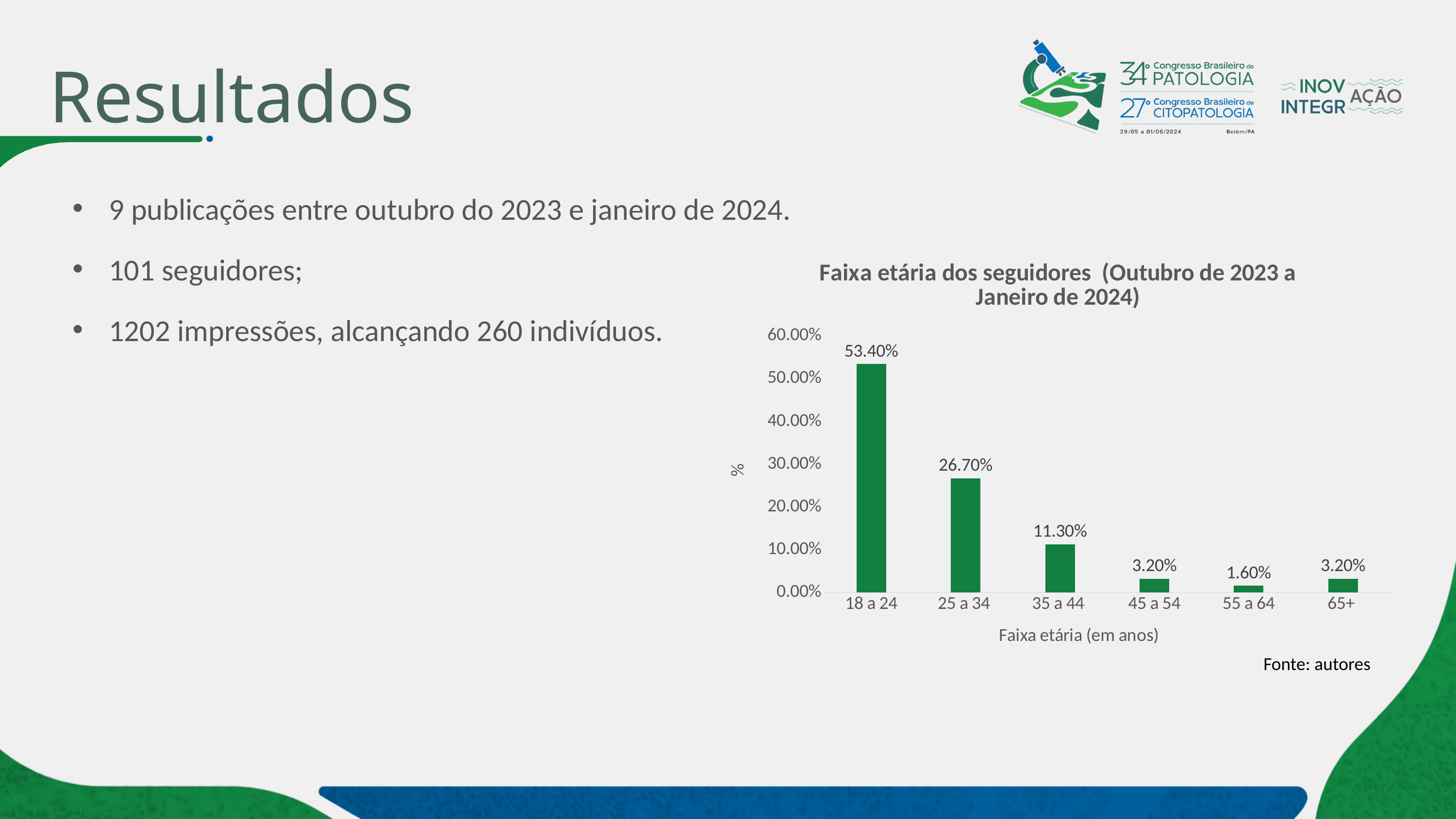
What kind of chart is shown on the slide? bar chart What is the value for the 25 a 34 age group? 26.70% Which age group has the highest value? 18 a 24 What is the difference between the values for 18 a 24 and 25 a 34? 26.70% Which is larger, the value for 35 a 44 or the value for 45 a 54? 35 a 44 What is the title of the chart? Faixa etária dos seguidores (Outubro de 2023 a Janeiro de 2024) Is the value for 25 a 34 greater or less than 30.00%? less Which age group has the lowest value? 55 a 64 What is the value for the 18 a 24 age group? 53.40% How many age groups are shown on the x axis? 6 What is the value for the 35 a 44 age group? 11.30% What is the value for the 55 a 64 age group? 1.60%